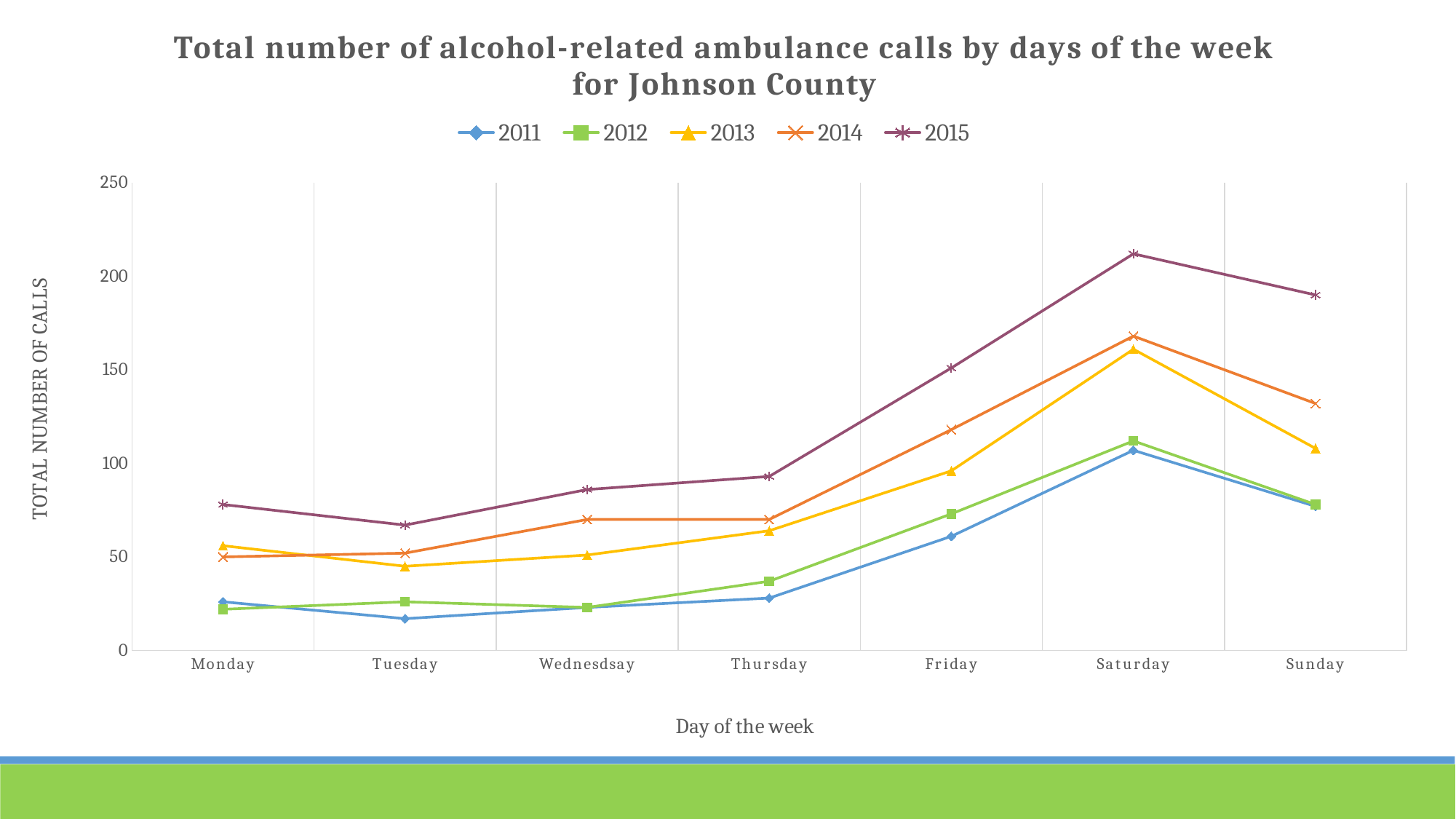
What is the title of the vertical axis? TOTAL NUMBER OF CALLS On Friday, which series has the larger value, 2014 or 2013? 2014 Is the value for 2014 on Sunday greater or less than 150? less Is the value for 2015 on Saturday greater or less than 200? greater Which series has the highest value on Monday? 2015 On which day of the week does the 2011 series have its lowest value? Tuesday Do the values for 2015 rise or fall from Thursday to Saturday? rise Is the value for 2013 on Saturday greater or less than 150? greater On which day of the week does the 2015 series reach its highest value? Saturday What kind of chart is shown on the slide? line chart How many days of the week are plotted along the x axis? 7 How many series does the legend list? 5